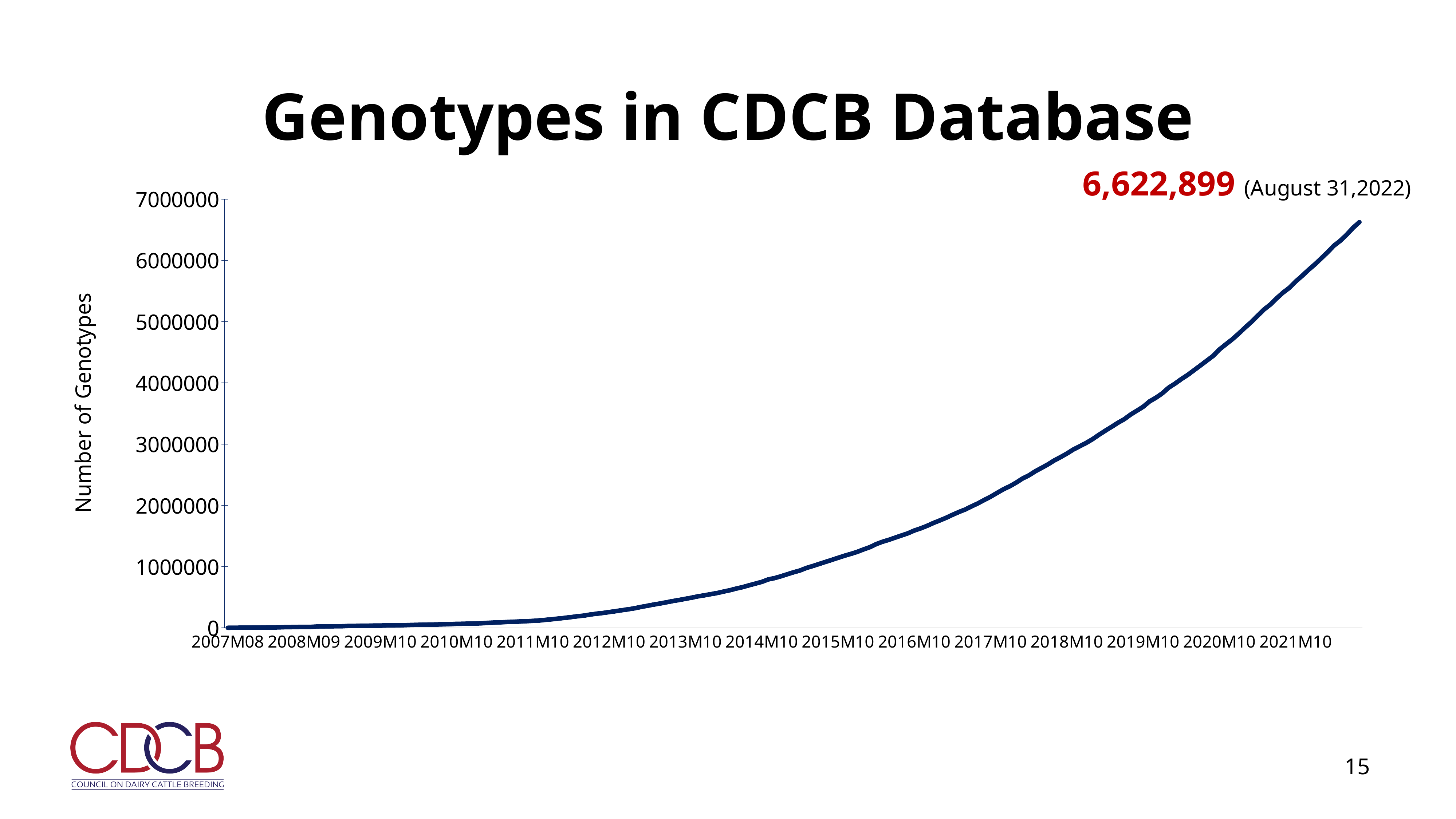
Is the value for 2019M10 greater or less than 3000000? greater Is the value for 2016M10 greater or less than 1000000? greater What kind of chart is shown on the slide? line chart Is the value for 2021M10 greater or less than 5000000? greater Which has a larger number of genotypes, 2015M10 or 2020M10? 2020M10 Does the number of genotypes rise or fall over time along the x axis? rise What is the label of the y axis? Number of Genotypes How many tick labels are shown on the x axis? 15 What is the number of genotypes in the CDCB database as of August 31, 2022, according to the annotation? 6,622,899